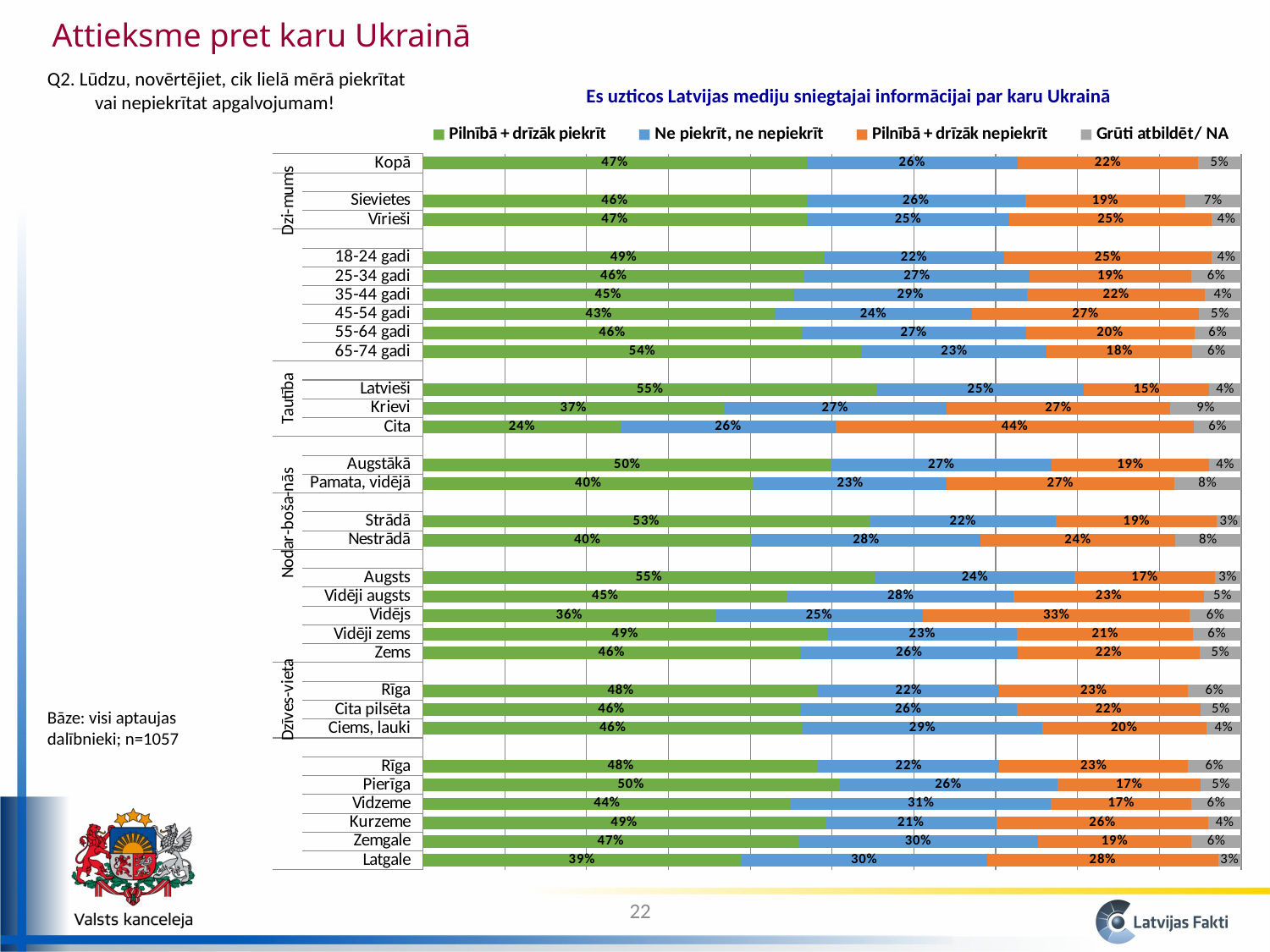
Which has a larger "Pilnībā + drīzāk piekrīt" value, Strādā or Nestrādā? Strādā What is the value of "Pilnībā + drīzāk nepiekrīt" for Cita (Tautība)? 44% Which category has the highest value for "Pilnībā + drīzāk nepiekrīt"? Cita What is the value of "Grūti atbildēt/ NA" for Krievi? 9% What is the value of "Pilnībā + drīzāk piekrīt" for Kopā? 47% Which category has the lowest value for "Pilnībā + drīzāk nepiekrīt"? Latvieši How many series does the legend list? 4 Which category has the lowest value for "Pilnībā + drīzāk piekrīt"? Cita What is the title of the chart? Es uzticos Latvijas mediju sniegtajai informācijai par karu Ukrainā What kind of chart is shown on the slide? Stacked bar chart What is the value of "Ne piekrīt, ne nepiekrīt" for Vidzeme? 31% What is the difference between the "Pilnībā + drīzāk piekrīt" values for Latvieši and Krievi? 18%